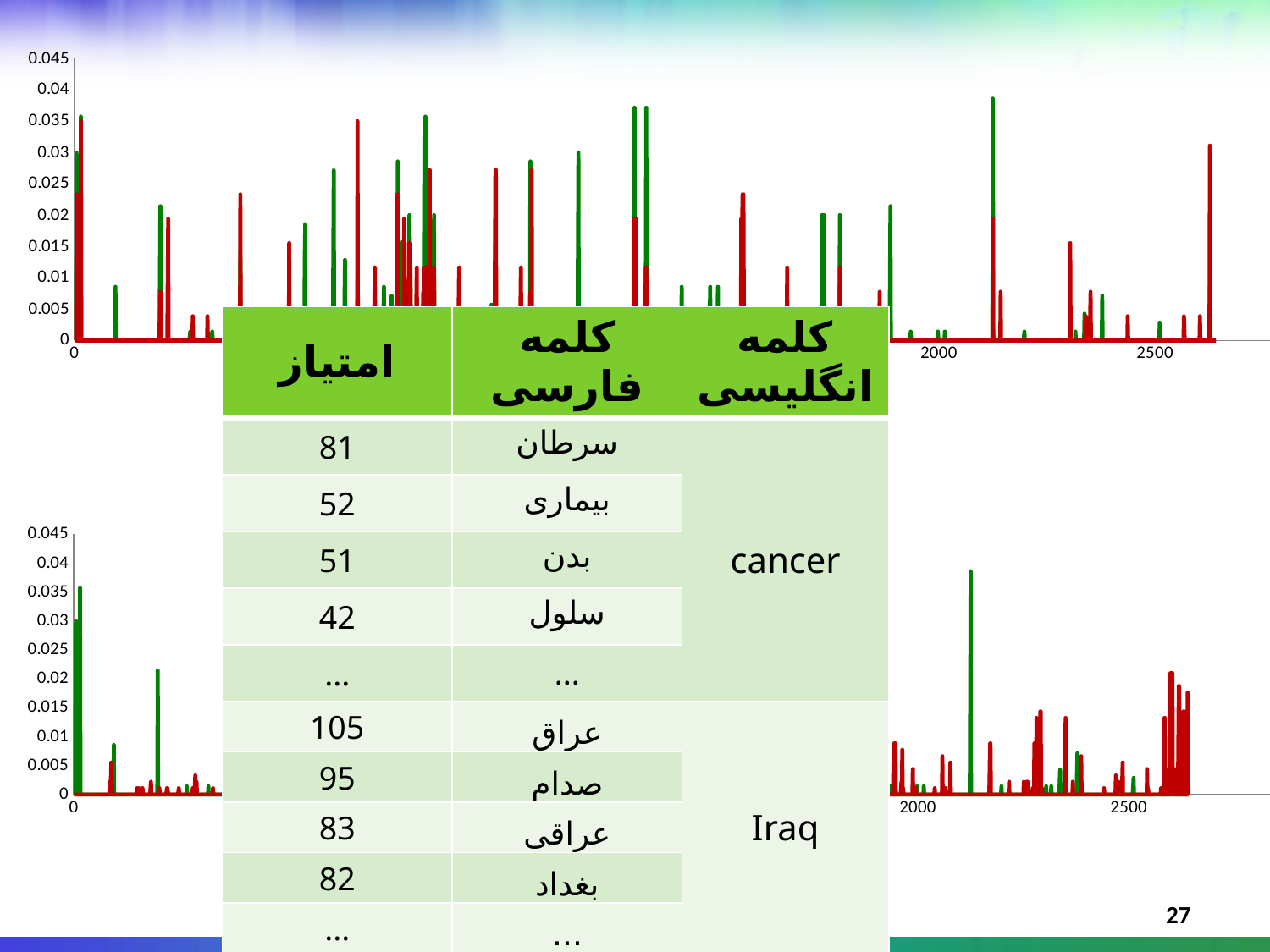
In the top chart, is the tallest bar greater or less than 0.04? less What is the lowest value shown on the y axis of the bottom chart? 0 In the bottom chart, is the tallest bar greater or less than 0.04? less In the bottom chart, is the tallest bar greater or less than 0.03? greater What kind of chart is the bottom chart on the slide? bar chart How many charts are shown on the slide? 2 What is the highest value shown on the y axis of the top chart? 0.045 What kind of chart is the top chart on the slide? bar chart